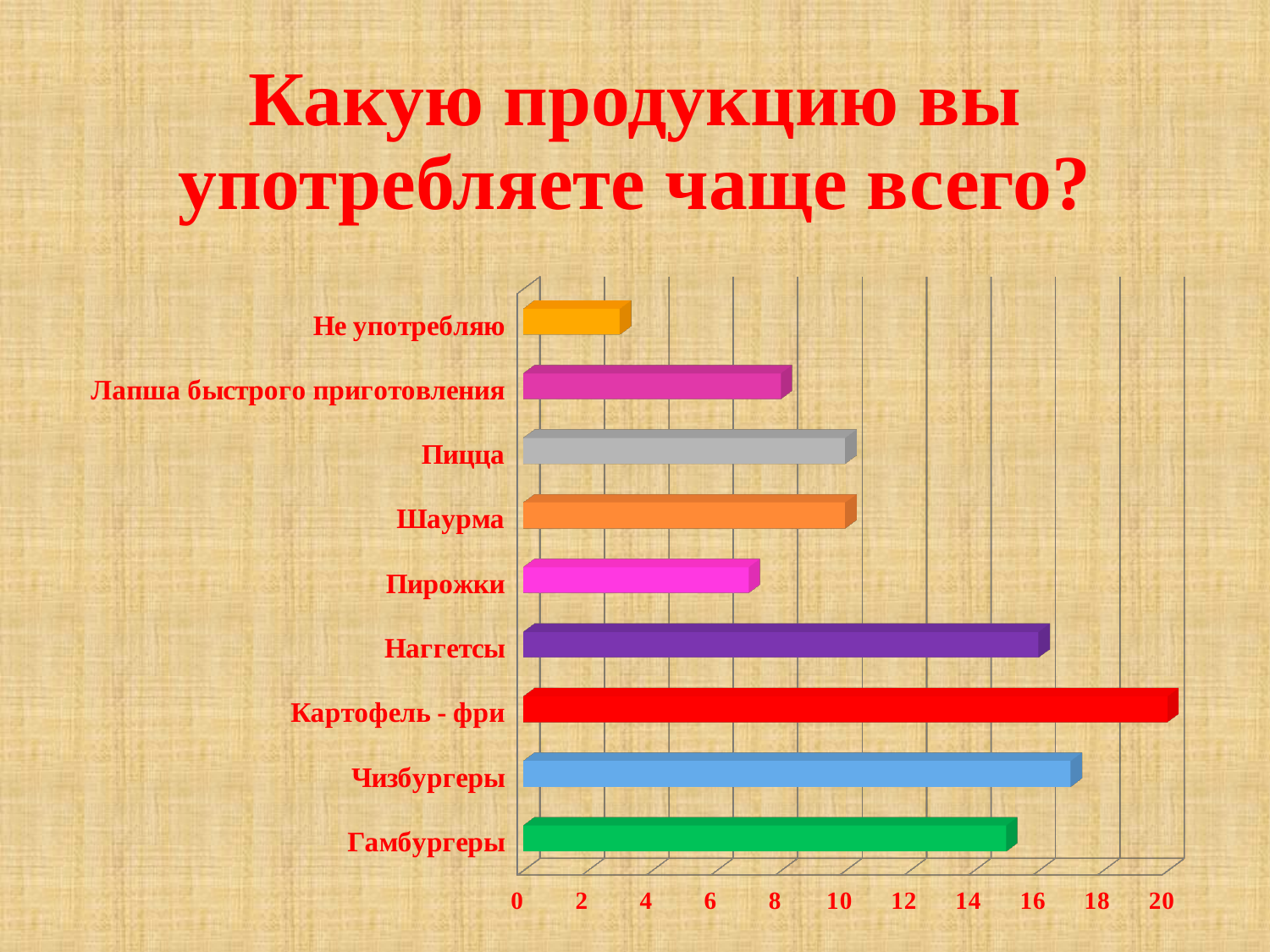
Which category has the lowest value on the chart? Не употребляю Which has a larger value, Чизбургеры or Гамбургеры? Чизбургеры Is the value for Наггетсы greater or less than 14? greater What is the title of the slide above the chart? Какую продукцию вы употребляете чаще всего? Which category has the highest value on the chart? Картофель - фри Is the value for Не употребляю greater or less than 4? less Is the value for Пирожки greater or less than 10? less Which has a larger value, Наггетсы or Пирожки? Наггетсы What kind of chart is shown on the slide? bar chart How many product categories are shown on the chart? 9